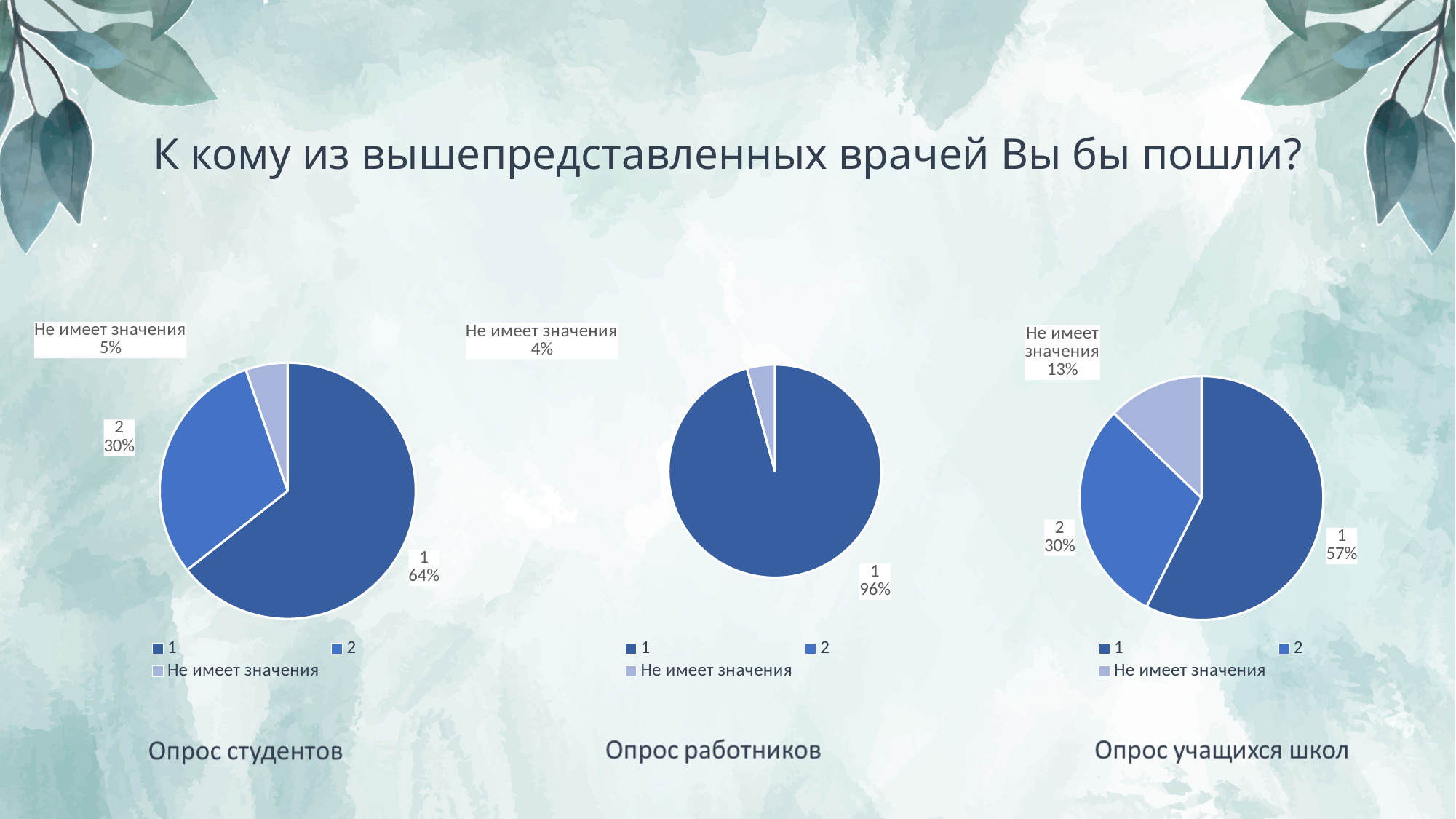
In the 'Опрос студентов' pie chart, what is the difference between the shares for category 1 and category 2? 34% Which is larger: the share for category 1 in the 'Опрос работников' chart or the share for category 1 in the 'Опрос учащихся школ' chart? Опрос работников In the 'Опрос учащихся школ' pie chart, which category has the largest slice? 1 In the 'Опрос студентов' pie chart, what share is labelled for 'Не имеет значения'? 5% In the 'Опрос студентов' pie chart, which category has the smallest slice? Не имеет значения In the 'Опрос учащихся школ' pie chart, what share is labelled for category 2? 30% In the 'Опрос студентов' pie chart, what share is labelled for category 1? 64% In the 'Опрос работников' pie chart, what share is labelled for 'Не имеет значения'? 4% In the 'Опрос учащихся школ' pie chart, what share is labelled for 'Не имеет значения'? 13% What type of chart is used for 'Опрос работников'? Pie chart How many entries does the legend of the 'Опрос студентов' pie chart list? 3 In the 'Опрос работников' pie chart, what share is labelled for category 1? 96%